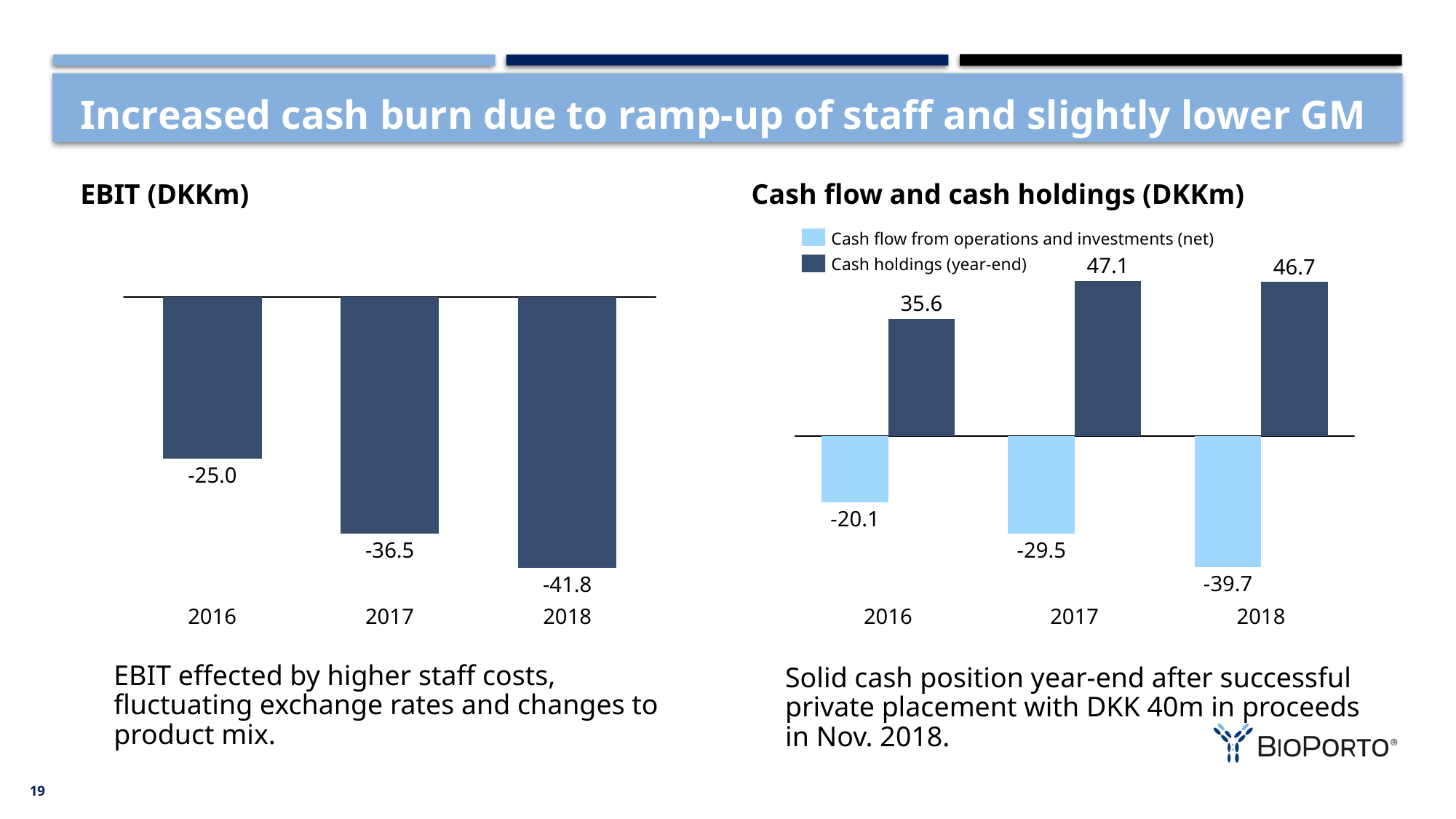
How many series does the legend of the Cash flow and cash holdings (DKKm) chart list? 2 In the Cash flow and cash holdings (DKKm) chart, which is larger: cash holdings in 2016 or cash holdings in 2018? 2018 In the EBIT (DKKm) chart, what is the value for 2017? -36.5 In the Cash flow and cash holdings (DKKm) chart, what is the cash holdings (year-end) value for 2016? 35.6 In the Cash flow and cash holdings (DKKm) chart, which year has the highest cash holdings (year-end)? 2017 In the Cash flow and cash holdings (DKKm) chart, what is the cash flow from operations and investments (net) for 2018? -39.7 In the EBIT (DKKm) chart, how many years are shown? 3 In the EBIT (DKKm) chart, which year has the lowest EBIT? 2018 What type of chart is the EBIT (DKKm) chart? bar chart In the EBIT (DKKm) chart, do the values rise or fall from 2016 to 2018? fall In the EBIT (DKKm) chart, what is the difference between the 2016 and 2018 values? 16.8 In the Cash flow and cash holdings (DKKm) chart, what is the difference between cash holdings in 2017 and 2016? 11.5